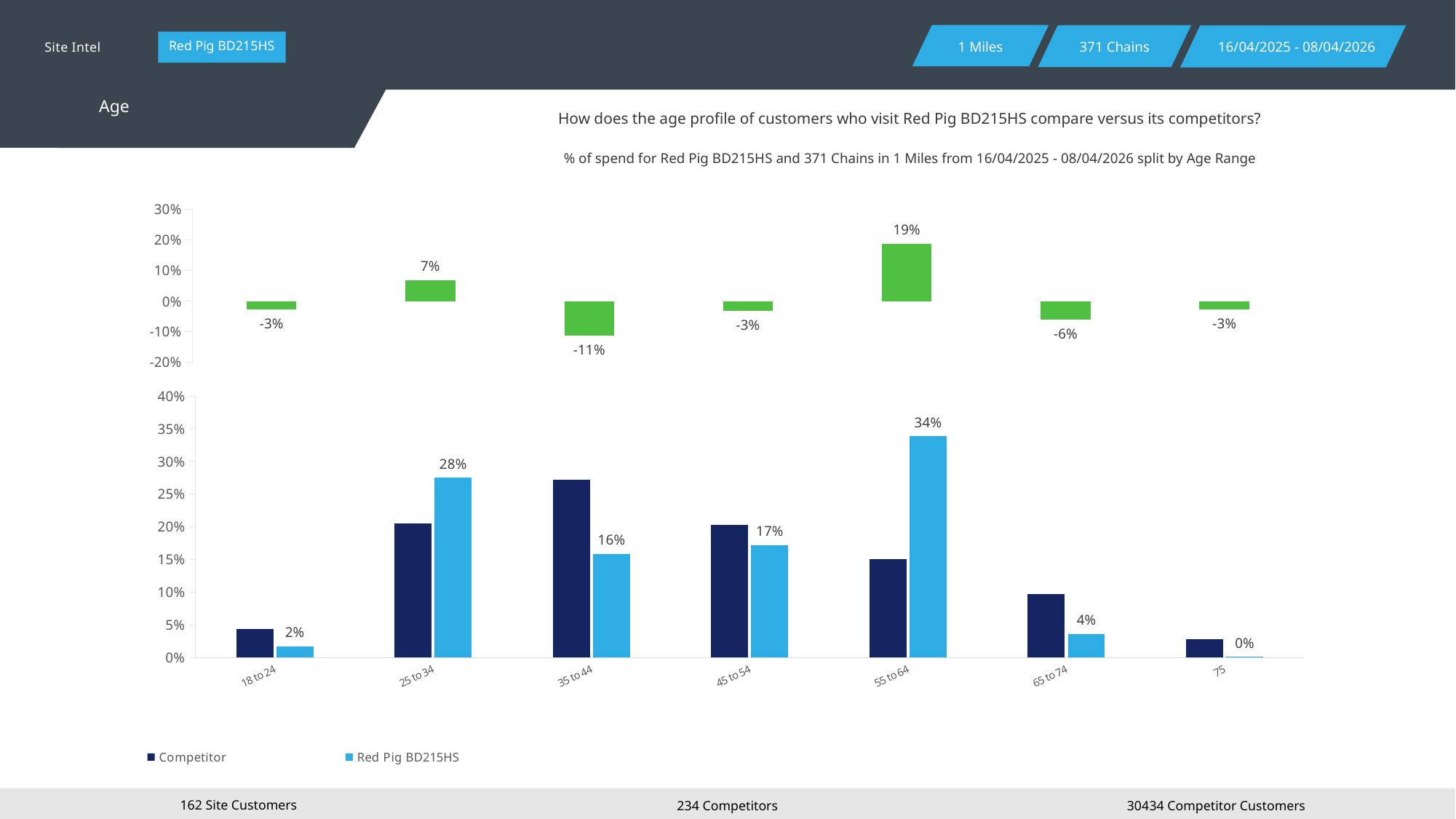
In the top chart, which age range has the highest value? 55 to 64 In the bottom chart, which is larger for the 35 to 44 age range: the Competitor bar or the Red Pig BD215HS bar? Competitor In the bottom chart, is the Competitor value for 35 to 44 greater or less than 25%? greater How many age range categories are shown on the x axis of the bottom chart? 7 In the bottom chart, what is the value for Red Pig BD215HS in the 25 to 34 age range? 28% In the bottom chart, what is the value for Red Pig BD215HS in the 55 to 64 age range? 34% In the bottom chart, which age range has the lowest Red Pig BD215HS value? 75 In the bottom chart, is the Competitor value for 65 to 74 greater or less than 15%? less In the top chart, what is the value for the 35 to 44 age range? -11% In the bottom chart, what is the difference between the Red Pig BD215HS values for 55 to 64 and 25 to 34? 6% In the top chart, which age range has the lowest value? 35 to 44 How many series does the legend of the bottom chart list? 2